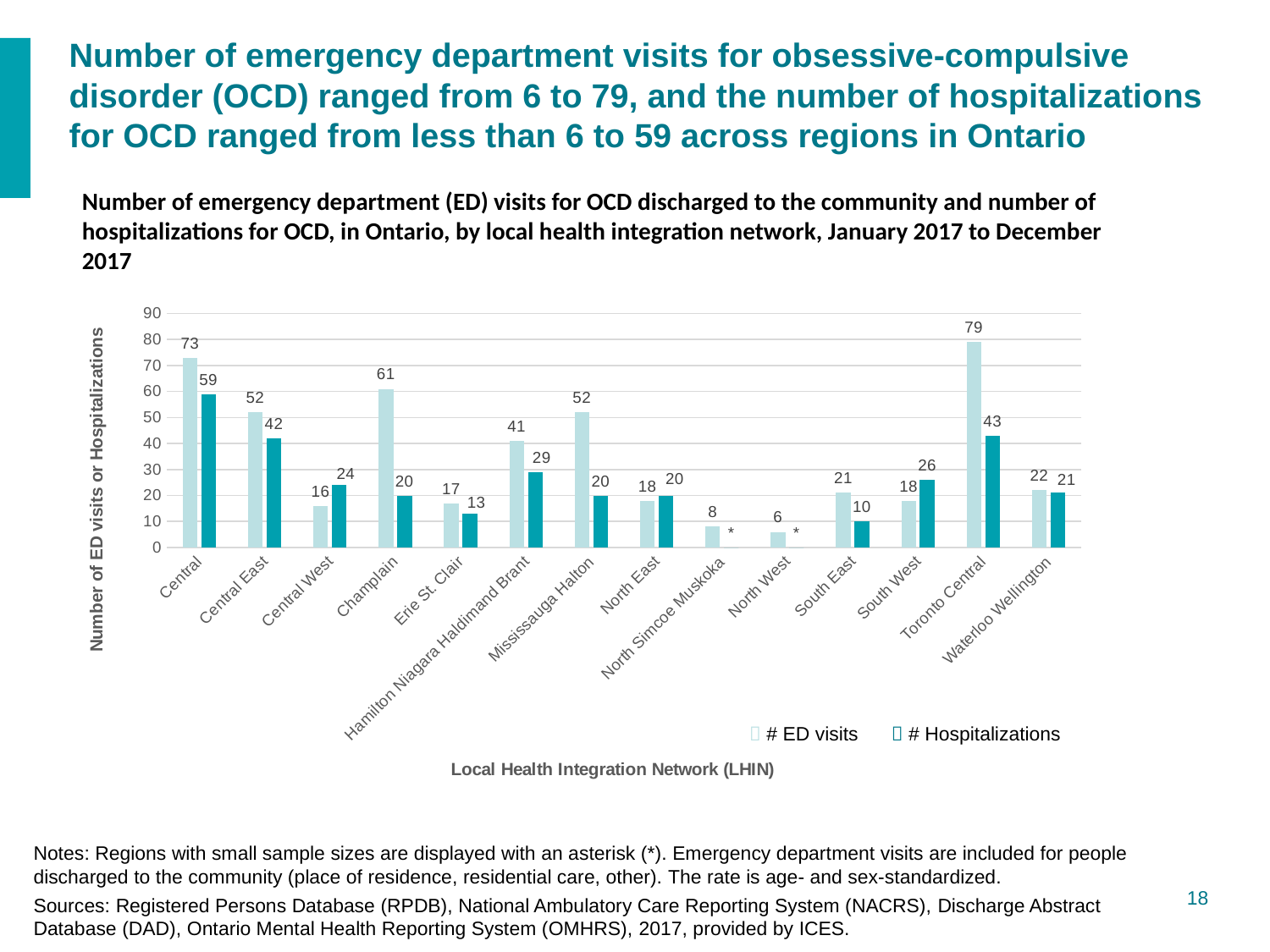
What is the number of ED visits for Champlain? 61 How many series does the legend list? 2 Which LHIN has the highest number of ED visits? Toronto Central Which LHIN has the lowest number of ED visits? North West What is the number of hospitalizations for Central East? 42 What is the number of hospitalizations for South West? 26 What is the difference between the number of ED visits and the number of hospitalizations for Central? 14 Which LHIN has the highest number of hospitalizations? Central How many LHINs are shown on the x axis of the chart? 14 For Central West, which is larger: the number of ED visits or the number of hospitalizations? # Hospitalizations What are the two series named in the legend? # ED visits and # Hospitalizations What kind of chart is shown on the slide? Bar chart